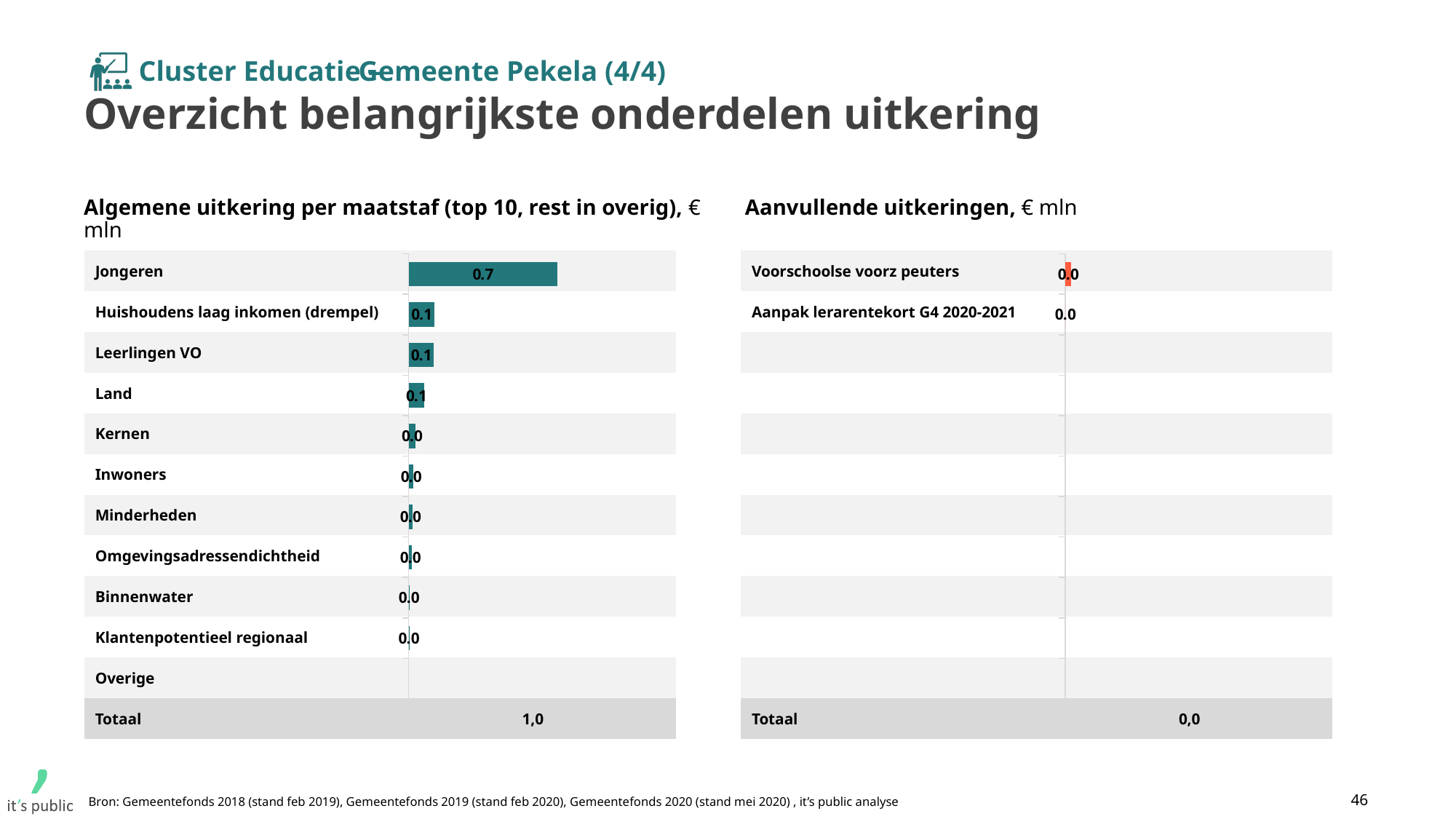
What kind of chart is used for 'Algemene uitkering per maatstaf'? Bar chart In the chart 'Algemene uitkering per maatstaf', which is larger: the value for Jongeren or the value for Land? Jongeren In the chart 'Algemene uitkering per maatstaf', do the values rise or fall going from the top row (Jongeren) down to Klantenpotentieel regionaal? Fall In the chart 'Algemene uitkering per maatstaf', what is the Totaal shown at the bottom? 1,0 What unit is stated in the title of the chart on the right side of the slide? € mln In the chart 'Algemene uitkering per maatstaf', what is the value for Leerlingen VO? 0.1 In the chart 'Aanvullende uitkeringen', how many named categories have a value shown? 2 In the chart 'Aanvullende uitkeringen', what is the value for Voorschoolse voorz peuters? 0.0 In the chart 'Aanvullende uitkeringen', what is the Totaal shown at the bottom? 0,0 In the chart 'Algemene uitkering per maatstaf', what is the value for Jongeren? 0.7 In the chart 'Algemene uitkering per maatstaf', which maatstaf has the highest value? Jongeren In the chart 'Algemene uitkering per maatstaf', what is the difference between the values for Jongeren and Huishoudens laag inkomen (drempel)? 0.6